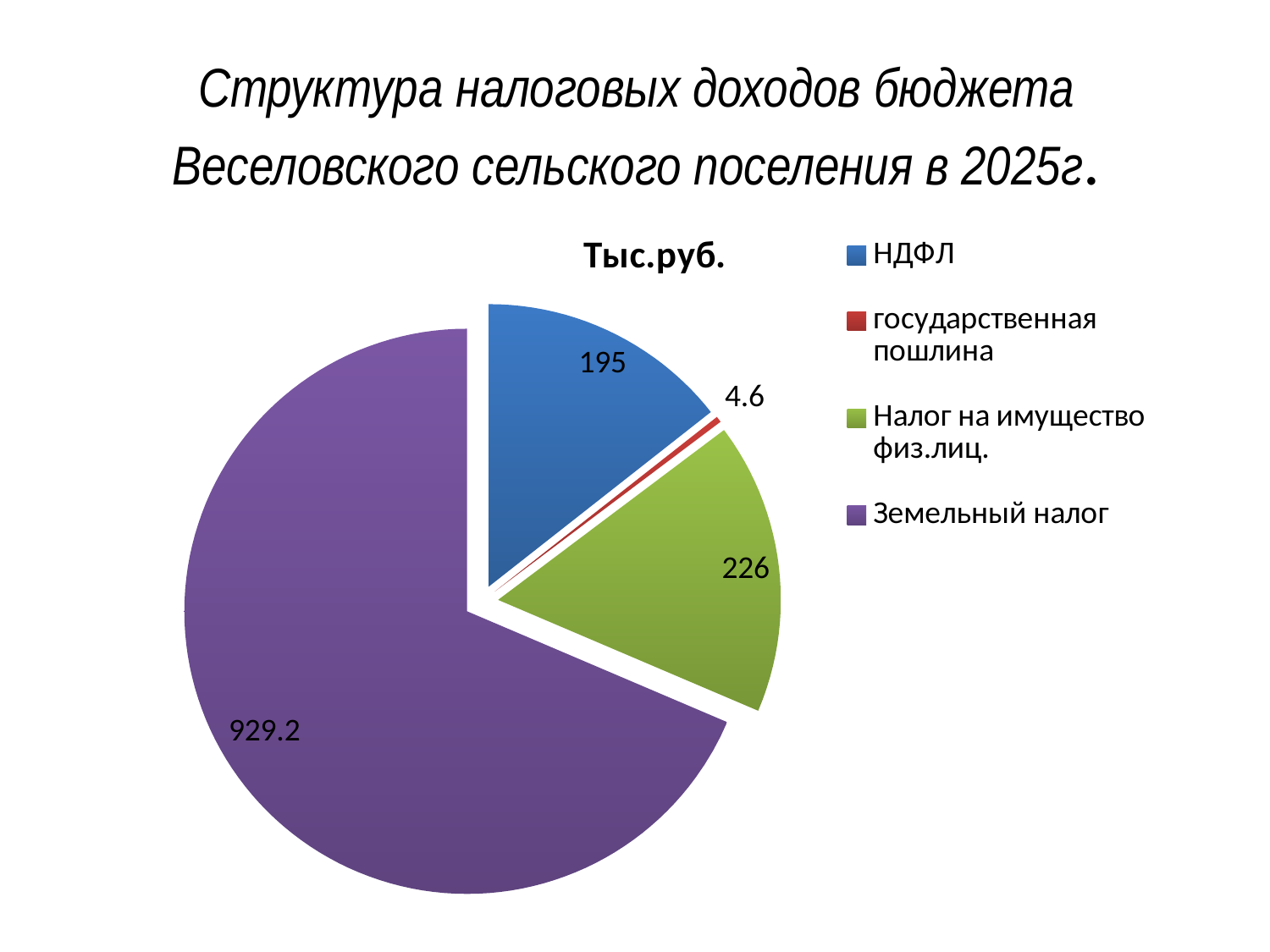
What is the value for Налог на имущество физ.лиц.? 226 What is the value for Земельный налог? 929.2 Which is larger, the value for НДФЛ or the value for Налог на имущество физ.лиц.? Налог на имущество физ.лиц. What is the difference between the values for Земельный налог and Налог на имущество физ.лиц.? 703.2 Which category has the smallest slice of the pie? государственная пошлина What is the value for НДФЛ? 195 What is the difference between the values for Налог на имущество физ.лиц. and НДФЛ? 31 What is the title shown above the pie chart? Тыс.руб. Which category has the largest slice of the pie? Земельный налог What is the value for государственная пошлина? 4.6 What type of chart is shown on the slide? pie chart How many categories does the legend list? 4